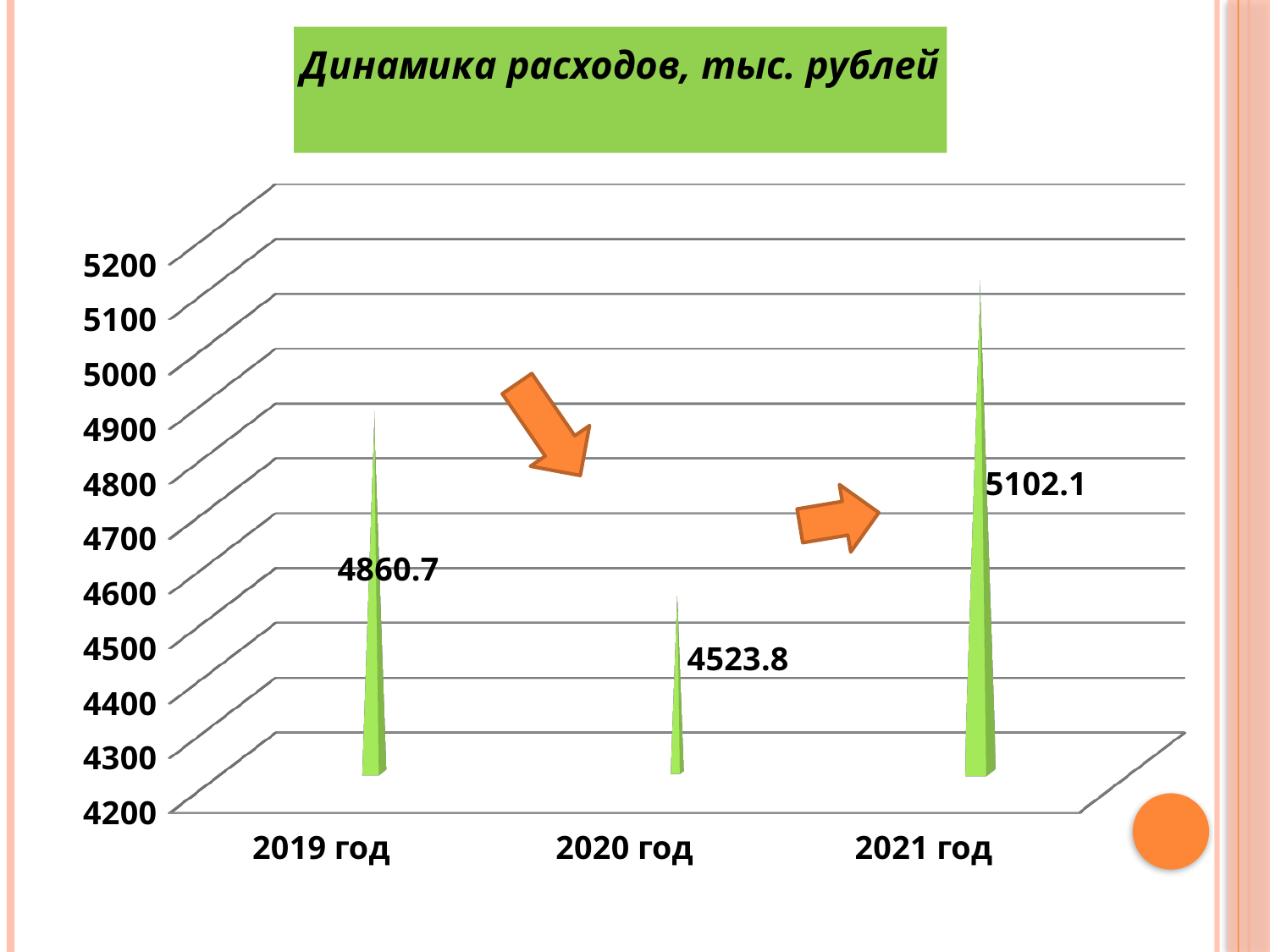
What is the value for 2019 год? 4860.7 How many years are shown on the x axis? 3 What is the value for 2020 год? 4523.8 What is the value for 2021 год? 5102.1 What is the difference between the values for 2021 год and 2020 год? 578.3 Which is larger, the value for 2019 год or the value for 2021 год? 2021 год Which year has the lowest value? 2020 год What is the title of the chart? Динамика расходов, тыс. рублей What kind of chart is shown on the slide? bar chart What is the difference between the values for 2019 год and 2020 год? 336.9 Is the value for 2020 год greater or less than 4600? less Which year has the highest value? 2021 год